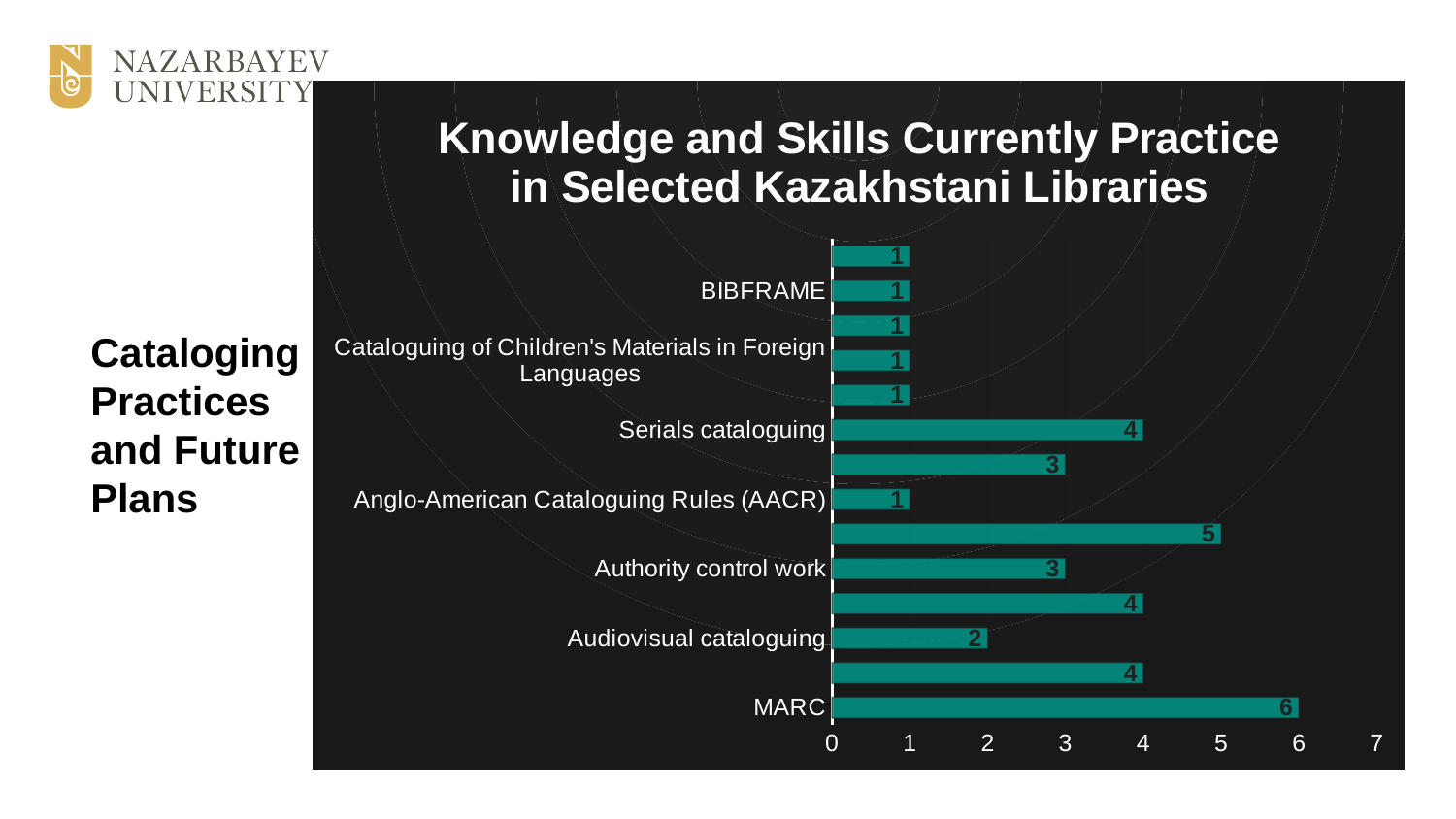
What is the value for Authority control work? 3 What is the title of the chart? Knowledge and Skills Currently Practice in Selected Kazakhstani Libraries What is the value for BIBFRAME? 1 What type of chart is shown on the slide? bar chart What is the value for Serials cataloguing? 4 What is the value for MARC? 6 What is the difference between the values for MARC and Audiovisual cataloguing? 4 Which is larger, the value for Serials cataloguing or the value for Authority control work? Serials cataloguing What is the value for Anglo-American Cataloguing Rules (AACR)? 1 What is the value for Audiovisual cataloguing? 2 Which labeled category has the highest value? MARC How many bars are plotted in the chart? 14